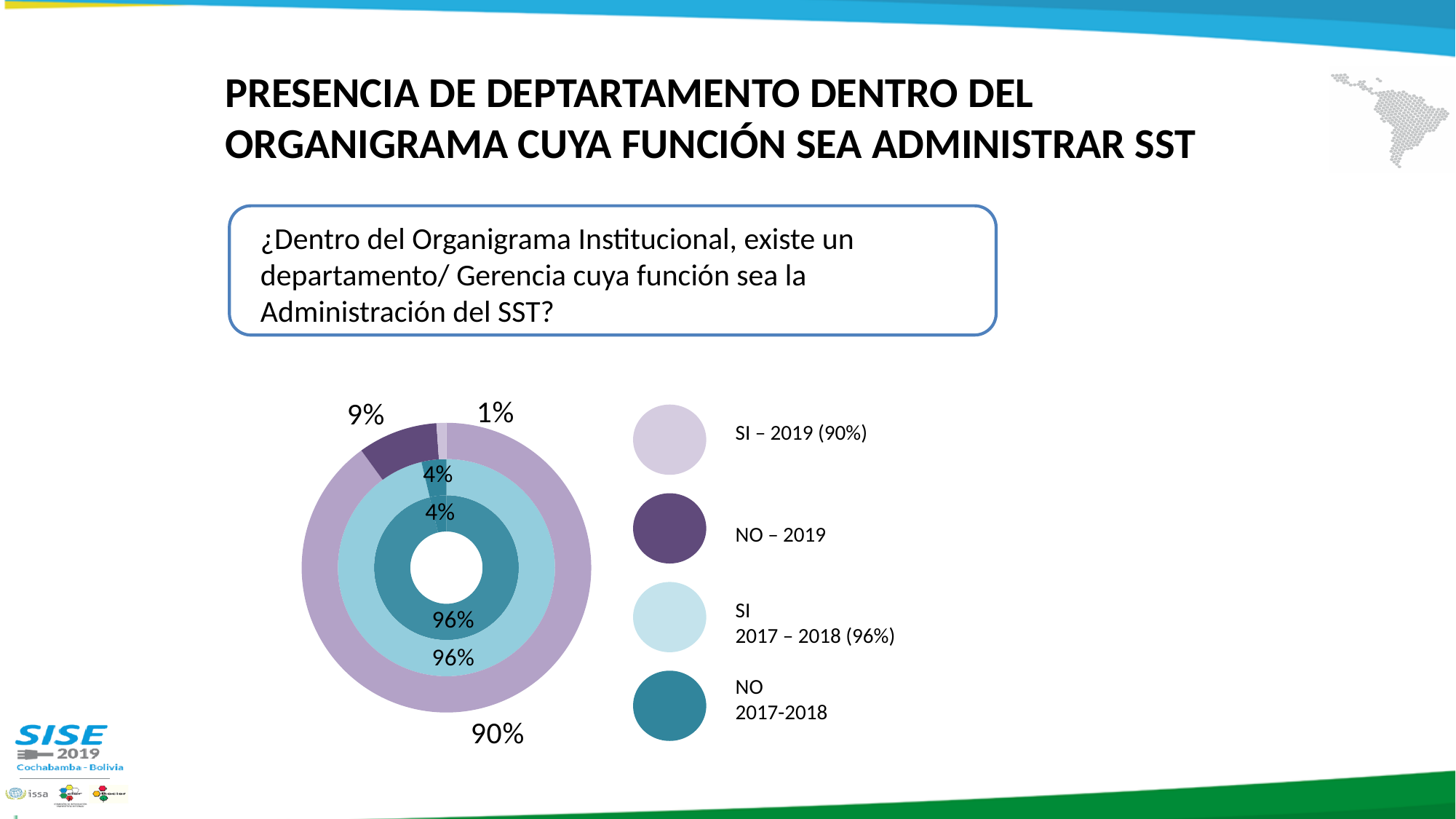
What percentage is shown for NO – 2019 in the outer ring of the donut chart? 9% Which is larger in the donut chart: SI – 2019 or NO – 2019? SI – 2019 What is the difference between the SI – 2019 value (90%) and the NO – 2019 value (9%)? 81 percentage points What percentage is shown for SI 2017 – 2018 in the donut chart? 96% What percentage is shown for SI – 2019 in the outer ring of the donut chart? 90% How many entries does the legend of the donut chart list? 4 What percentage is shown for NO 2017-2018 in the donut chart? 4% Which legend entry is shown in dark purple? NO – 2019 Which legend entry is shown in dark teal? NO 2017-2018 What is the smallest percentage labelled on the outer ring of the donut chart? 1% What kind of chart is shown on the slide? Donut chart What is the difference between the SI 2017 – 2018 value and the NO 2017-2018 value? 92 percentage points